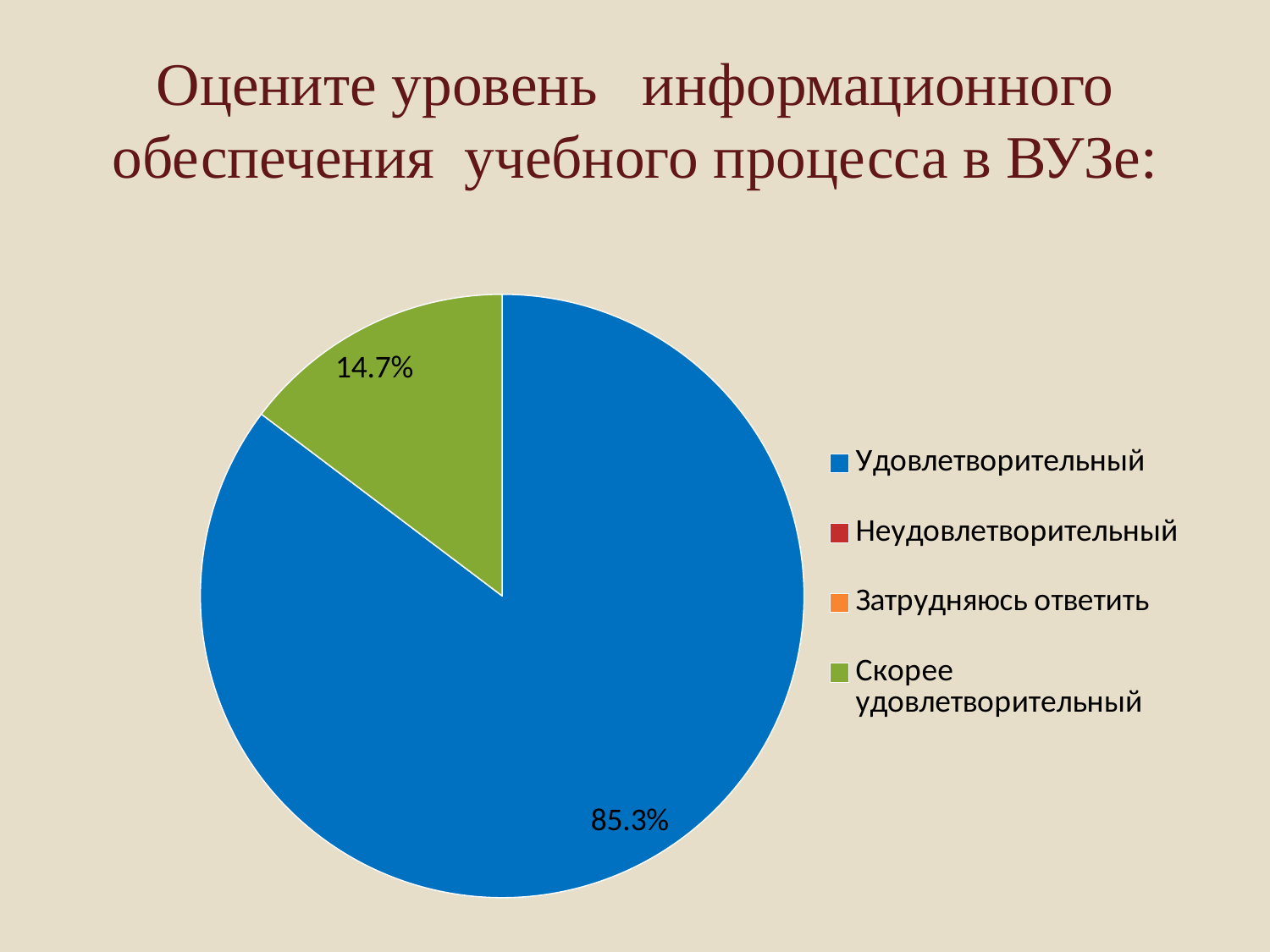
What is the title of the slide? Оцените уровень информационного обеспечения учебного процесса в ВУЗе: What colour is the "Скорее удовлетворительный" slice? Green How many entries does the legend list? 4 Which category has the largest slice of the pie? Удовлетворительный Which is larger: the "Удовлетворительный" slice or the "Скорее удовлетворительный" slice? Удовлетворительный What share of the pie does the "Удовлетворительный" slice represent? 85.3% What kind of chart is shown on the slide? Pie chart What share of the pie does the "Скорее удовлетворительный" slice represent? 14.7% Is the share for "Удовлетворительный" greater or less than 50%? greater How many slices are visible in the pie? 2 What is the difference between the "Удовлетворительный" and "Скорее удовлетворительный" shares? 70.6%